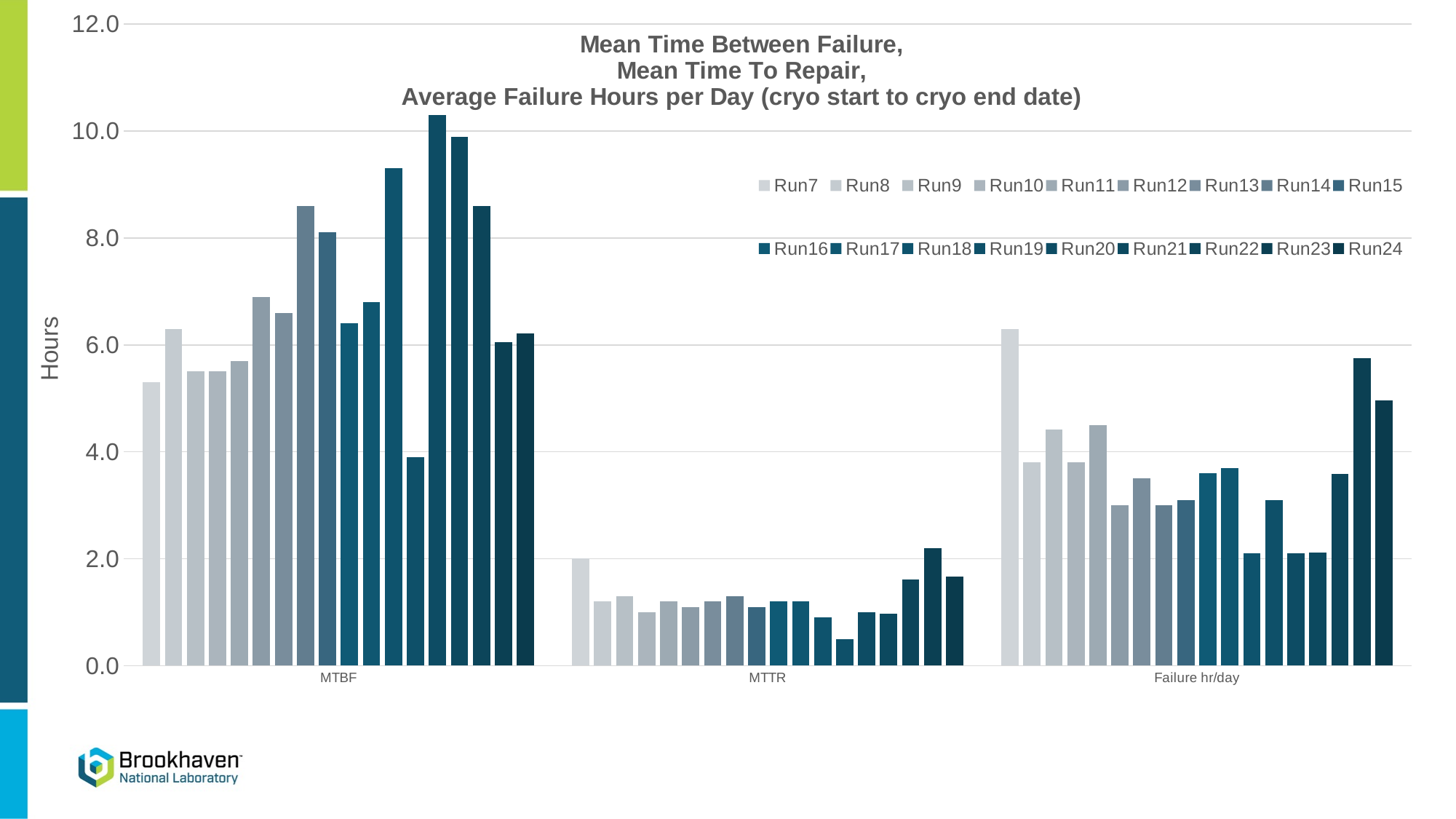
Is the value for Run7 in the MTBF category greater or less than 6.0? less What is the label of the y axis? Hours Which category has the tallest bars overall? MTBF Which category has the lowest values overall? MTTR Is the tallest bar in the MTBF category greater or less than 8.0? greater Which is larger: the Run7 bar for MTBF or the Run7 bar for MTTR? MTBF Is the value for Run24 in the MTTR category greater or less than 2.0? less How many categories are shown along the x axis? 3 What are the three category labels on the x axis? MTBF, MTTR, Failure hr/day What kind of chart is shown on the slide? Bar chart How many series does the legend list? 18